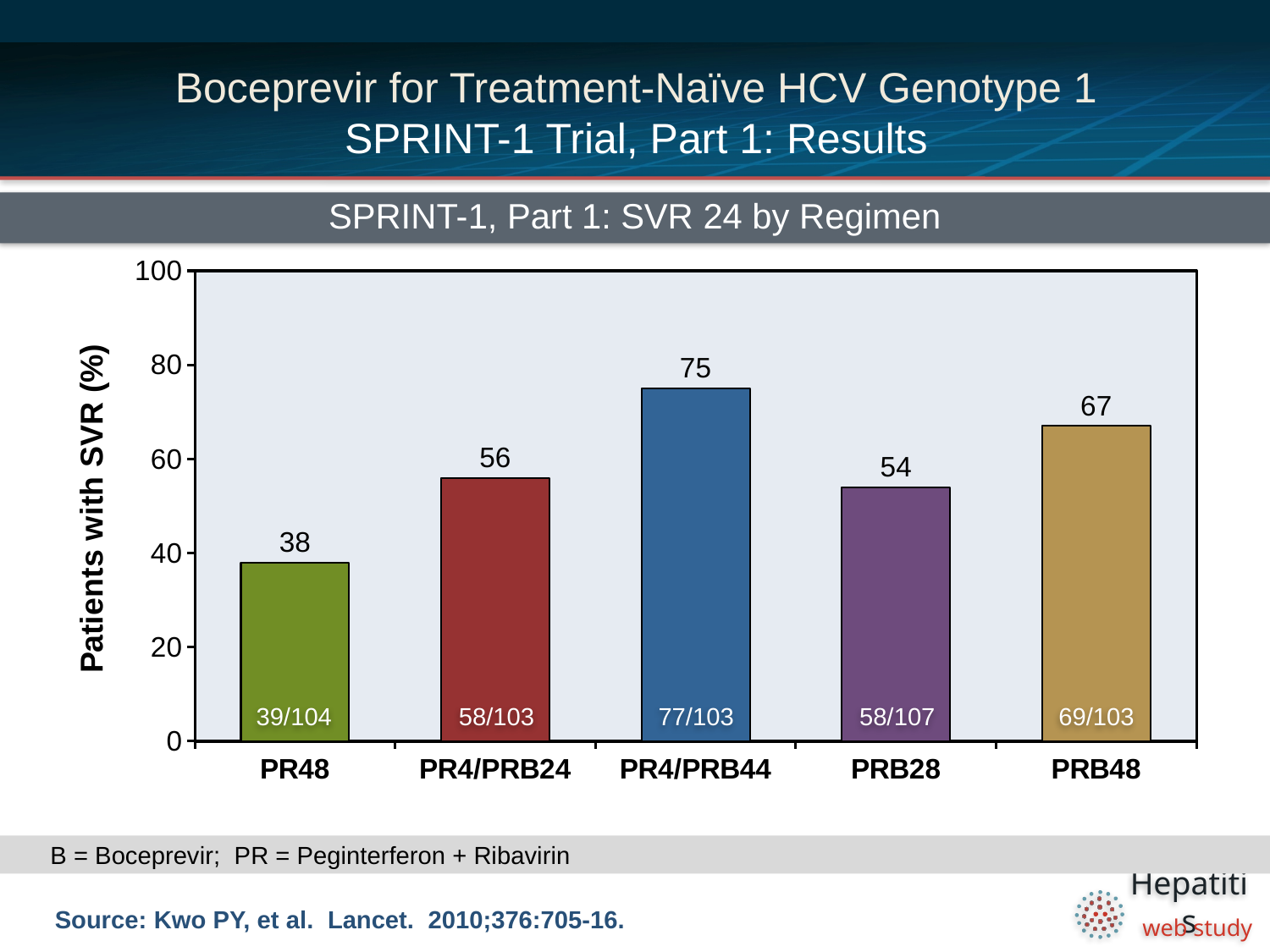
What is the title of the chart? SPRINT-1, Part 1: SVR 24 by Regimen What is the percentage of patients with SVR for the PR4/PRB44 regimen? 75 What fraction of patients is shown inside the PRB48 bar? 69/103 What is the difference in SVR percentage between PR4/PRB44 and PR48? 37 What kind of chart is shown on the slide? Bar chart Which regimen has the lowest percentage of patients with SVR? PR48 Which regimen has a higher SVR percentage, PR4/PRB24 or PRB48? PRB48 What is the label of the y-axis? Patients with SVR (%) How many regimens are shown on the chart? 5 What is the percentage of patients with SVR for the PRB28 regimen? 54 Which regimen has the highest percentage of patients with SVR? PR4/PRB44 What is the percentage of patients with SVR for the PR48 regimen? 38